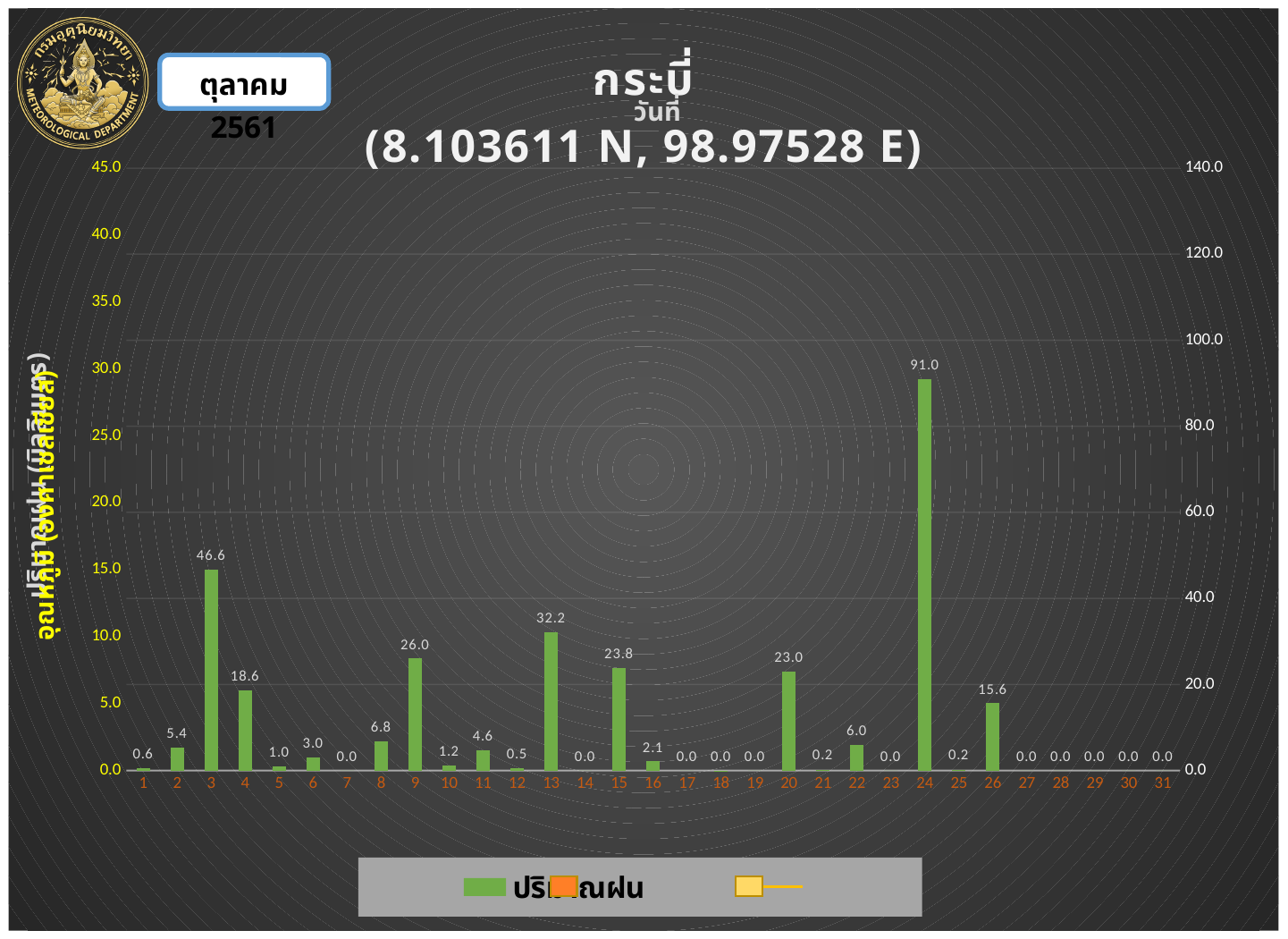
What kind of chart is this? bar chart What is the difference between the values for day 24 and day 3? 44.4 What is the value for day 3? 46.6 What is the value for day 26? 15.6 How many days are shown on the x axis? 31 Which is larger, the value for day 4 or the value for day 26? day 4 What is the value for day 13? 32.2 What is the value for day 24? 91.0 What is the difference between the values for day 15 and day 20? 0.8 Is the value for day 24 greater or less than 80.0 on the right axis? greater What is the value for day 9? 26.0 Which day has the highest value? 24